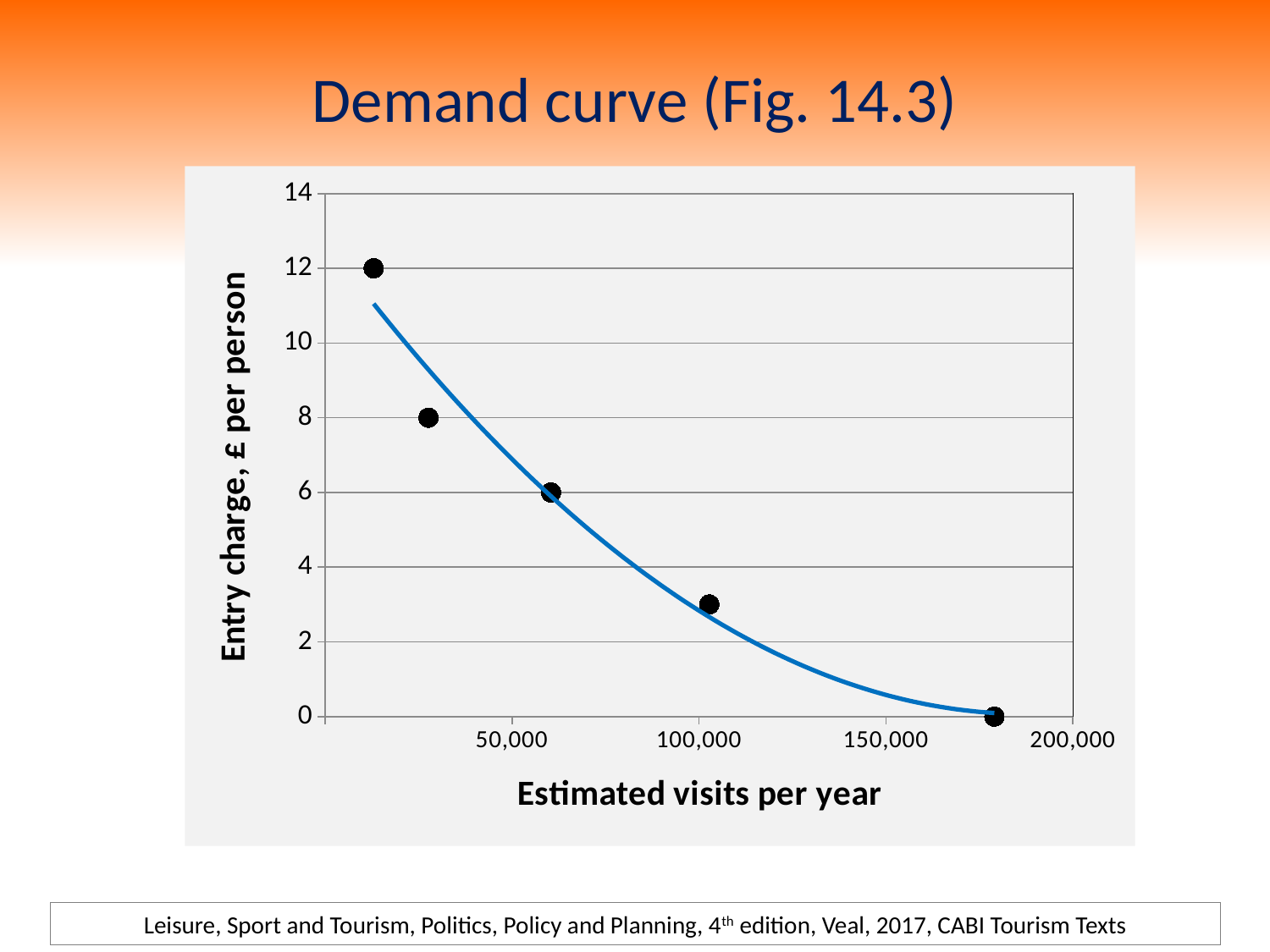
What kind of chart is shown on the slide? scatter chart How many data points are plotted on the chart? 5 Which point has more estimated visits per year: the one at an entry charge of £8 or the one at £6? £6 What is the highest entry charge (£ per person) among the plotted points? 12 What is the difference in entry charge between the highest point (£12) and the point at £8? 4 What is the lowest entry charge (£ per person) among the plotted points? 0 Is the number of estimated visits per year for the point at an entry charge of £0 greater or less than 150,000? greater What is the title of the x axis? Estimated visits per year Is the number of estimated visits per year for the point at an entry charge of £6 greater or less than 50,000? greater Is the number of estimated visits per year for the point at an entry charge of £12 greater or less than 50,000? less As estimated visits per year increase along the x axis, does the entry charge rise or fall? fall What is the title of the y axis? Entry charge, £ per person